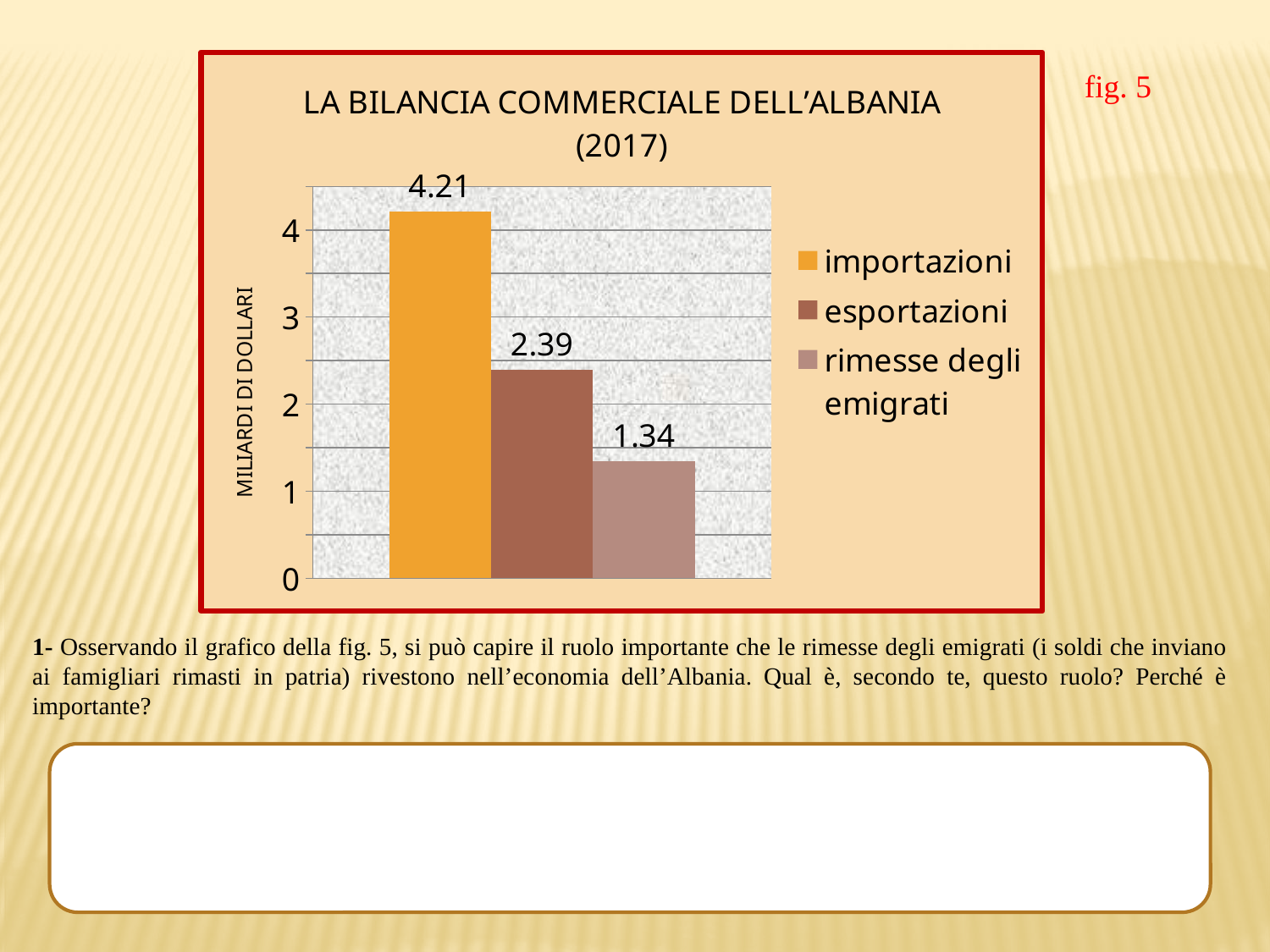
What is the value for rimesse degli emigrati? 1.34 What is the value for importazioni? 4.21 What is the label of the vertical axis? MILIARDI DI DOLLARI Which series has the lowest value? rimesse degli emigrati How many series does the legend list? 3 What is the value for esportazioni? 2.39 Which series has the highest value? importazioni What is the difference between importazioni and esportazioni? 1.82 What kind of chart is shown? bar chart Which is larger, esportazioni or rimesse degli emigrati? esportazioni What is the difference between esportazioni and rimesse degli emigrati? 1.05 Is the value for importazioni greater or less than 4? greater